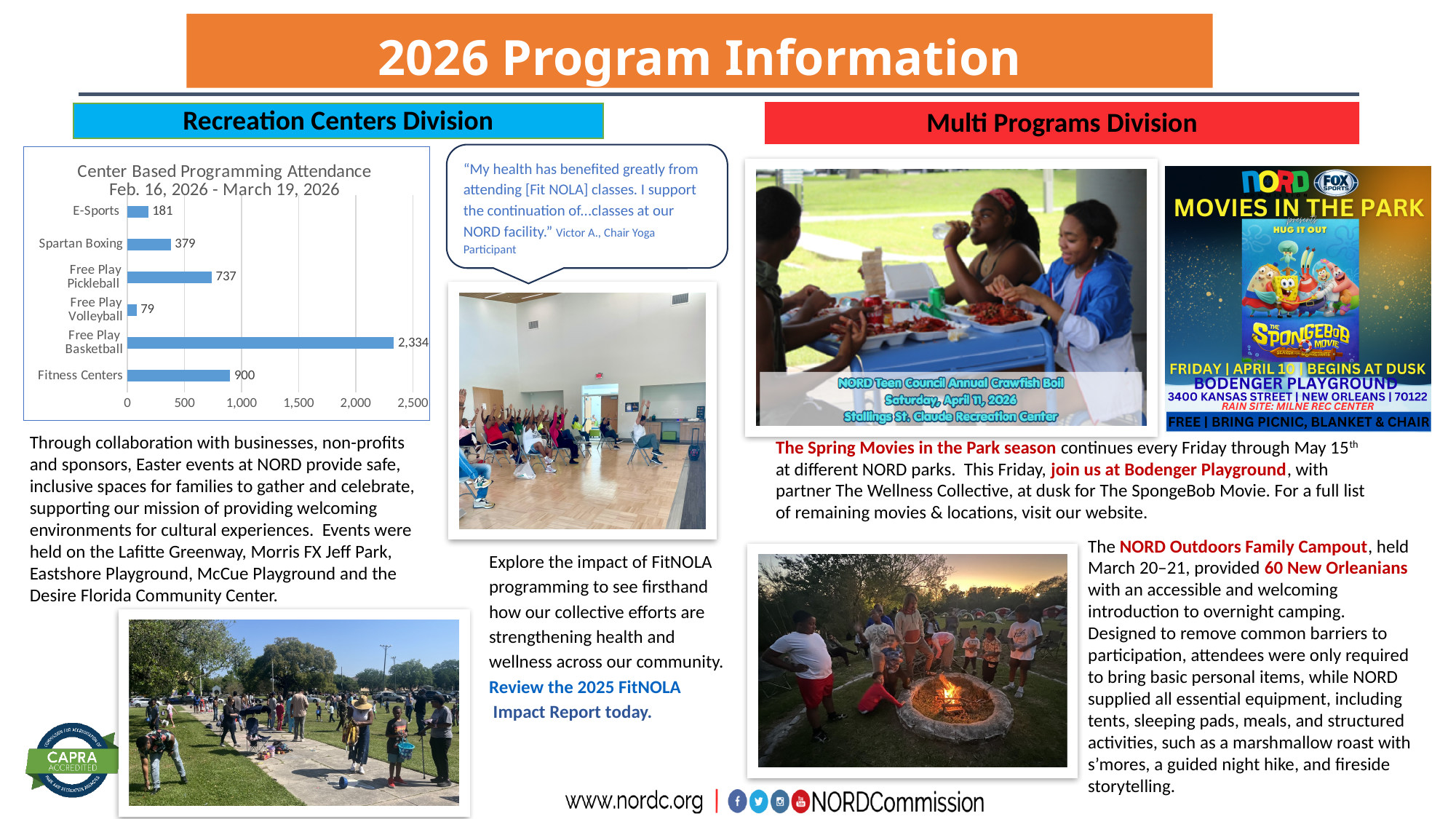
What type of chart is the Center Based Programming Attendance chart? Bar chart What is the attendance value for E-Sports in the Center Based Programming Attendance chart? 181 What is the difference in attendance between Free Play Pickleball and Spartan Boxing in the Center Based Programming Attendance chart? 358 What is the attendance value for Free Play Basketball in the Center Based Programming Attendance chart? 2,334 What is the attendance value for Fitness Centers in the Center Based Programming Attendance chart? 900 Which category has the highest attendance in the Center Based Programming Attendance chart? Free Play Basketball How many categories are shown in the Center Based Programming Attendance chart? 6 Is the attendance value for Free Play Basketball greater or less than 2,000 in the Center Based Programming Attendance chart? greater What is the attendance value for Spartan Boxing in the Center Based Programming Attendance chart? 379 What date range is given in the title of the Center Based Programming Attendance chart? Feb. 16, 2026 - March 19, 2026 Which category has the lowest attendance in the Center Based Programming Attendance chart? Free Play Volleyball In the Center Based Programming Attendance chart, which has higher attendance: Fitness Centers or Free Play Pickleball? Fitness Centers